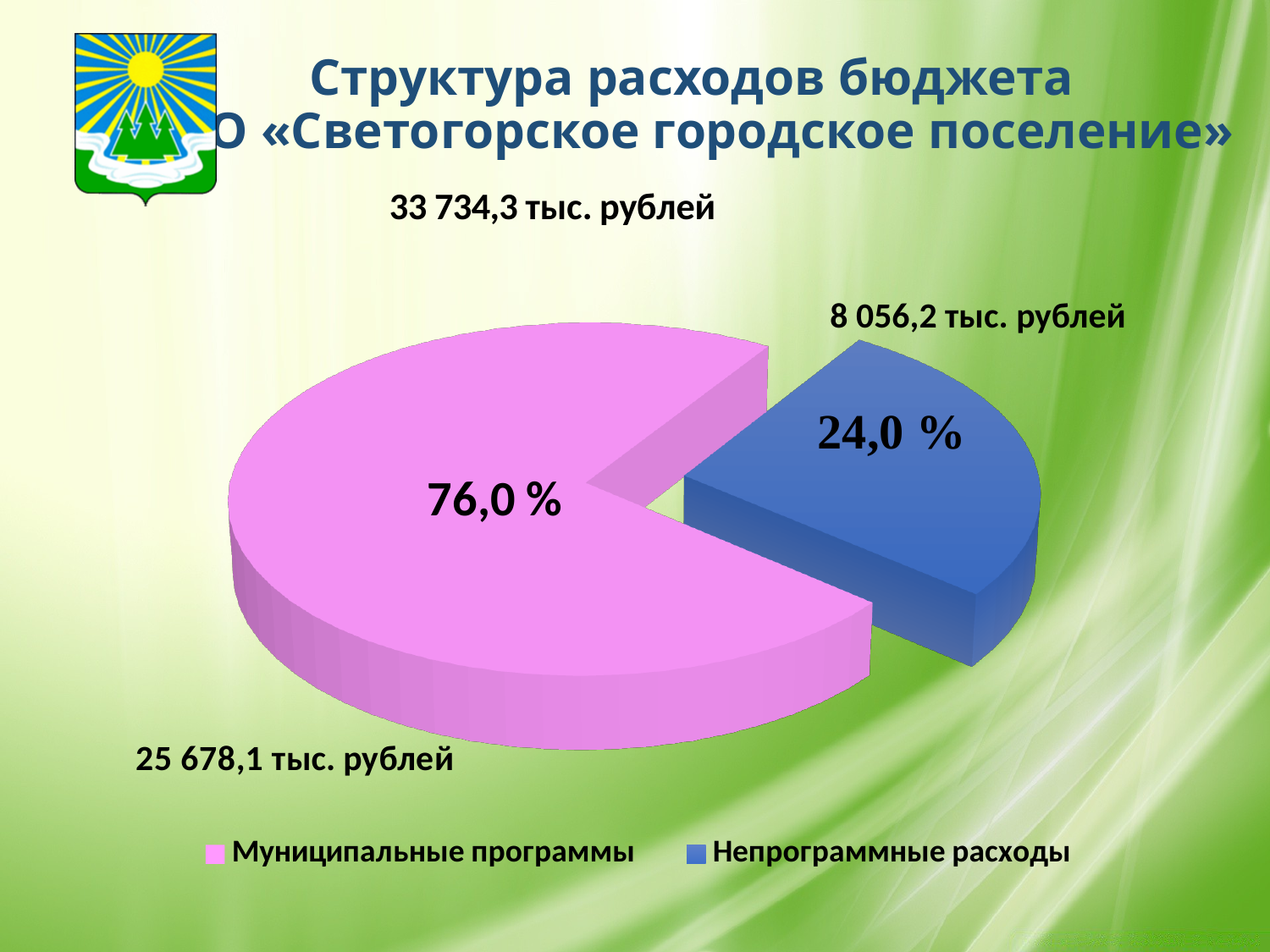
What kind of chart is shown on the slide? pie chart How many slices does the pie chart have? 2 Which category has the smallest slice of the pie? Непрограммные расходы Which category has the largest slice of the pie? Муниципальные программы What is the difference in percentage points between the Муниципальные программы and Непрограммные расходы slices? 52,0 % What share of the pie does Муниципальные программы take? 76,0 % How many entries does the legend list? 2 What is the value shown for Непрограммные расходы? 8 056,2 тыс. рублей Which is larger, Муниципальные программы or Непрограммные расходы? Муниципальные программы What share of the pie does Непрограммные расходы take? 24,0 % What total amount is shown above the pie chart? 33 734,3 тыс. рублей What is the value shown for Муниципальные программы? 25 678,1 тыс. рублей